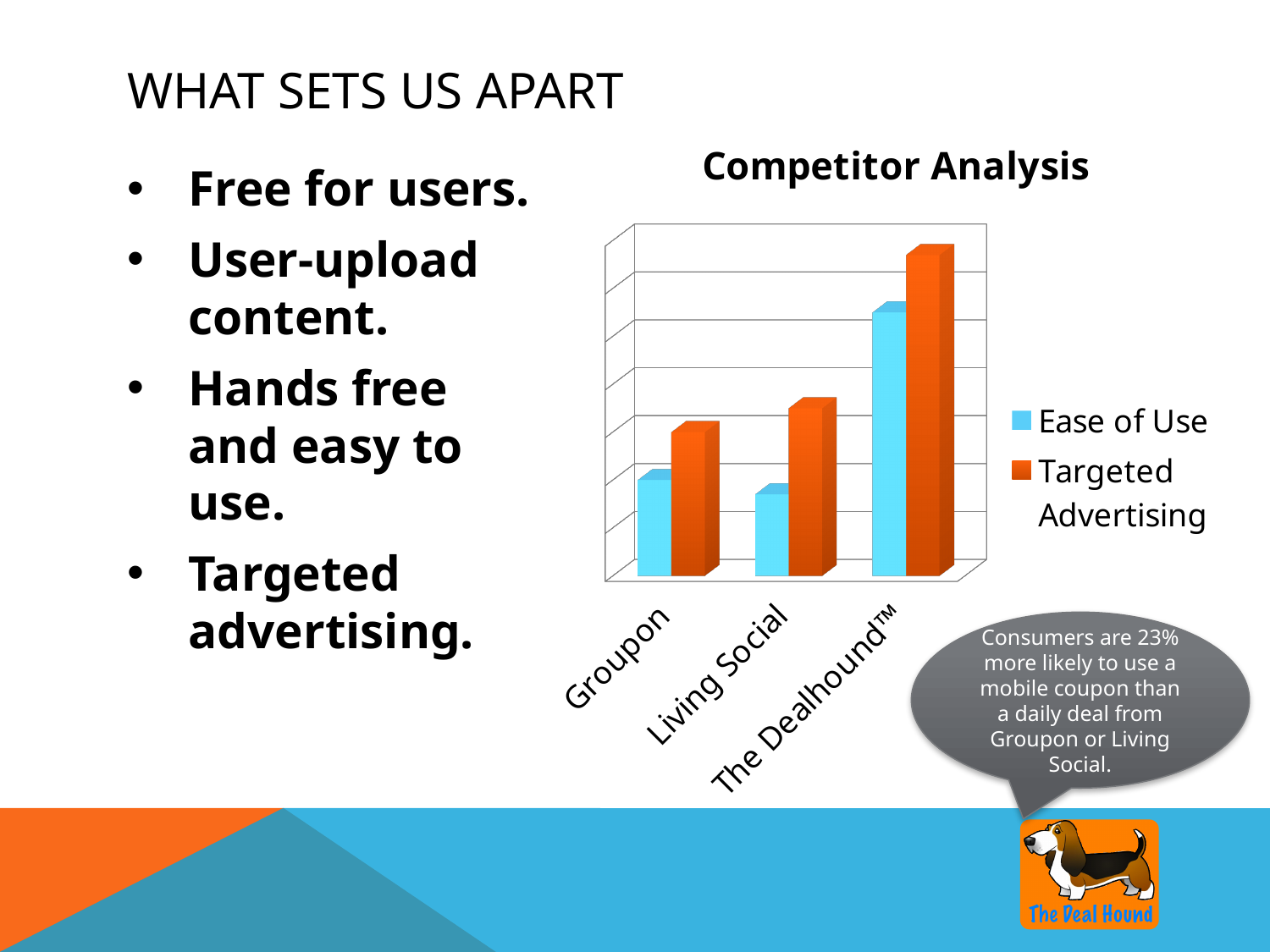
For Groupon, which is larger in the Competitor Analysis chart: Ease of Use or Targeted Advertising? Targeted Advertising Do the Targeted Advertising bars rise or fall from Groupon to The Dealhound™ along the x axis? rise What is the title of the chart on the slide? Competitor Analysis Which is larger in the Competitor Analysis chart: Targeted Advertising for Living Social or Targeted Advertising for The Dealhound™? The Dealhound™ Which competitor has the highest Targeted Advertising bar in the Competitor Analysis chart? The Dealhound™ How many series does the legend of the Competitor Analysis chart list? 2 Which competitor has the lowest Targeted Advertising bar in the Competitor Analysis chart? Groupon Which competitor has the highest Ease of Use bar in the Competitor Analysis chart? The Dealhound™ Which colour represents the Ease of Use series in the Competitor Analysis chart? blue Which is larger in the Competitor Analysis chart: Ease of Use for Groupon or Ease of Use for The Dealhound™? The Dealhound™ How many competitors (categories) are shown on the x axis of the Competitor Analysis chart? 3 What kind of chart is shown under the title "Competitor Analysis"? bar chart